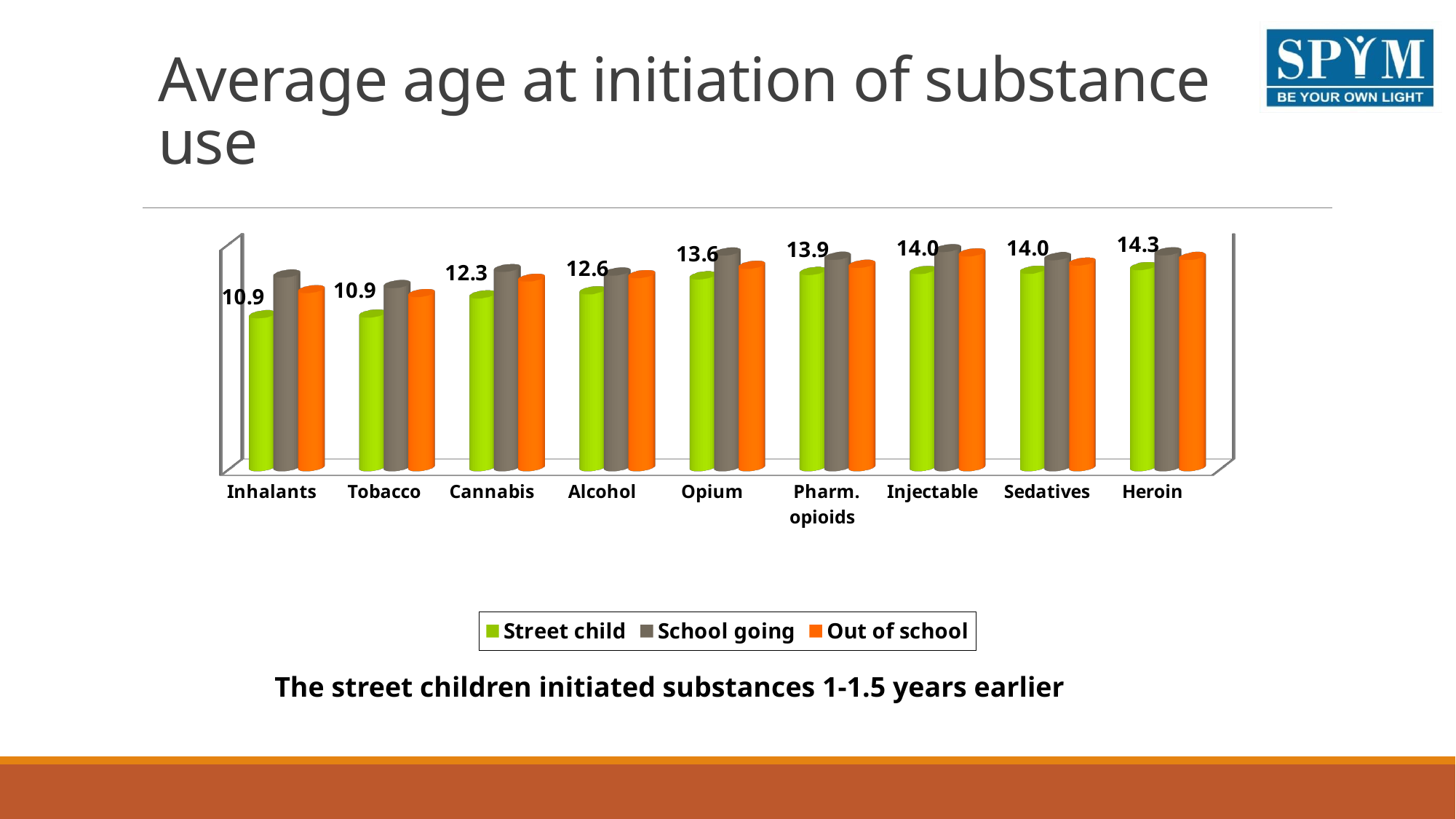
What is the Street child value for Pharm. opioids? 13.9 For Tobacco, which is larger: the Street child value or the Out of school value? Out of school How many series does the legend list? 3 Which substance has the highest Street child average age at initiation? Heroin What is the Street child value for Heroin? 14.3 What is the difference between the Street child values for Heroin and Inhalants? 3.4 How many substances are shown on the x axis? 9 What is the Street child value for Cannabis? 12.3 What is the Street child value for Opium? 13.6 What kind of chart is shown on the slide? Bar chart Do the Street child values rise or fall from Inhalants to Heroin along the x axis? Rise For Inhalants, which is larger: the Street child value or the School going value? School going